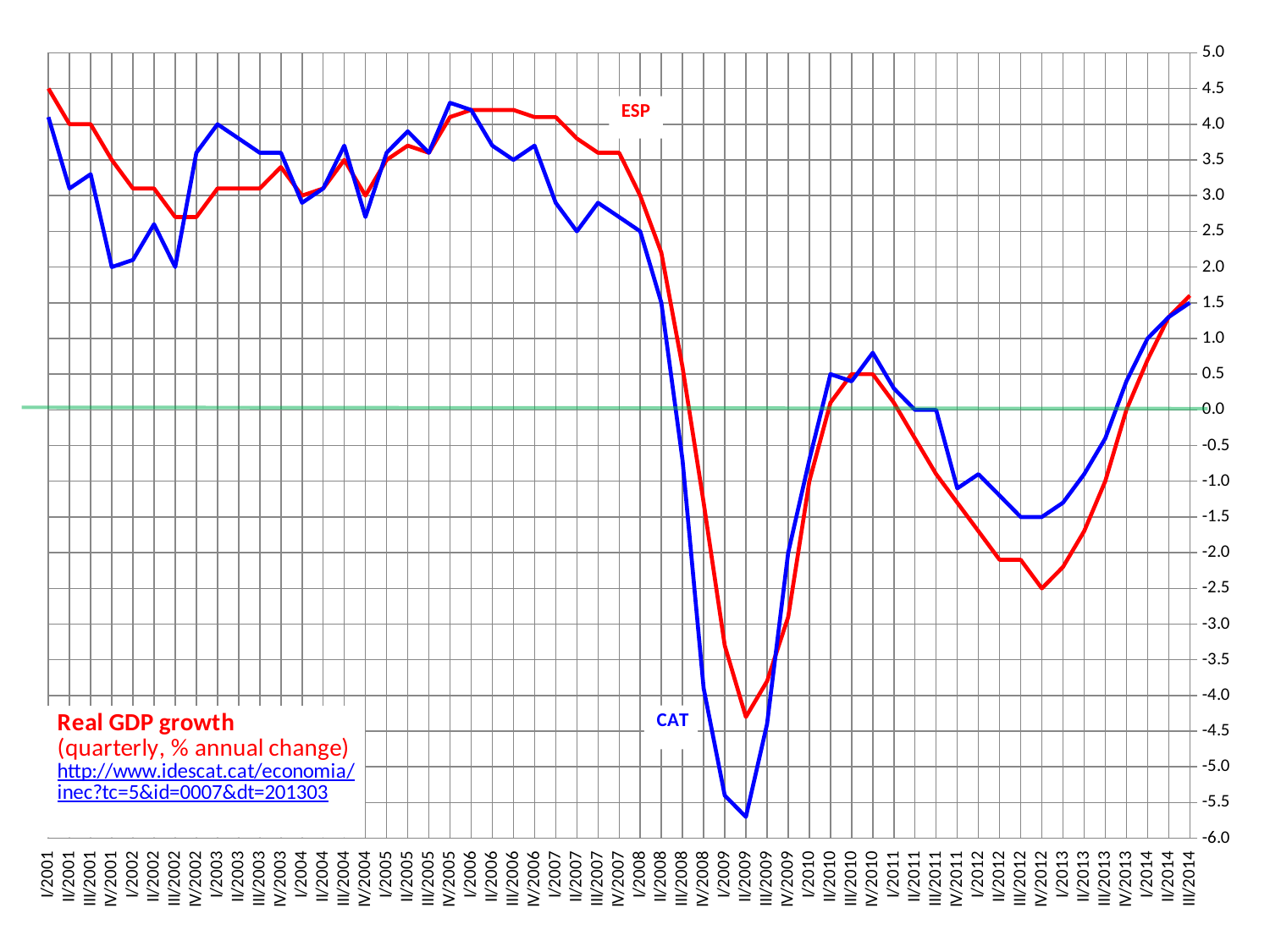
Which series reaches the lowest value on the chart? CAT What kind of chart is shown on the slide? line chart How many series are plotted on the chart? 2 What is the title of the chart? Real GDP growth In IV/2001, which series has the higher value, ESP or CAT? ESP Is the value for CAT in I/2005 greater or less than 3.0? greater Is the value for ESP in III/2002 greater or less than 3.0? less Is the value for CAT in II/2009 greater or less than -5.0? less What colour is the ESP line? red In IV/2012, which series has the higher value, ESP or CAT? CAT Does the CAT line rise or fall between I/2008 and II/2009? fall